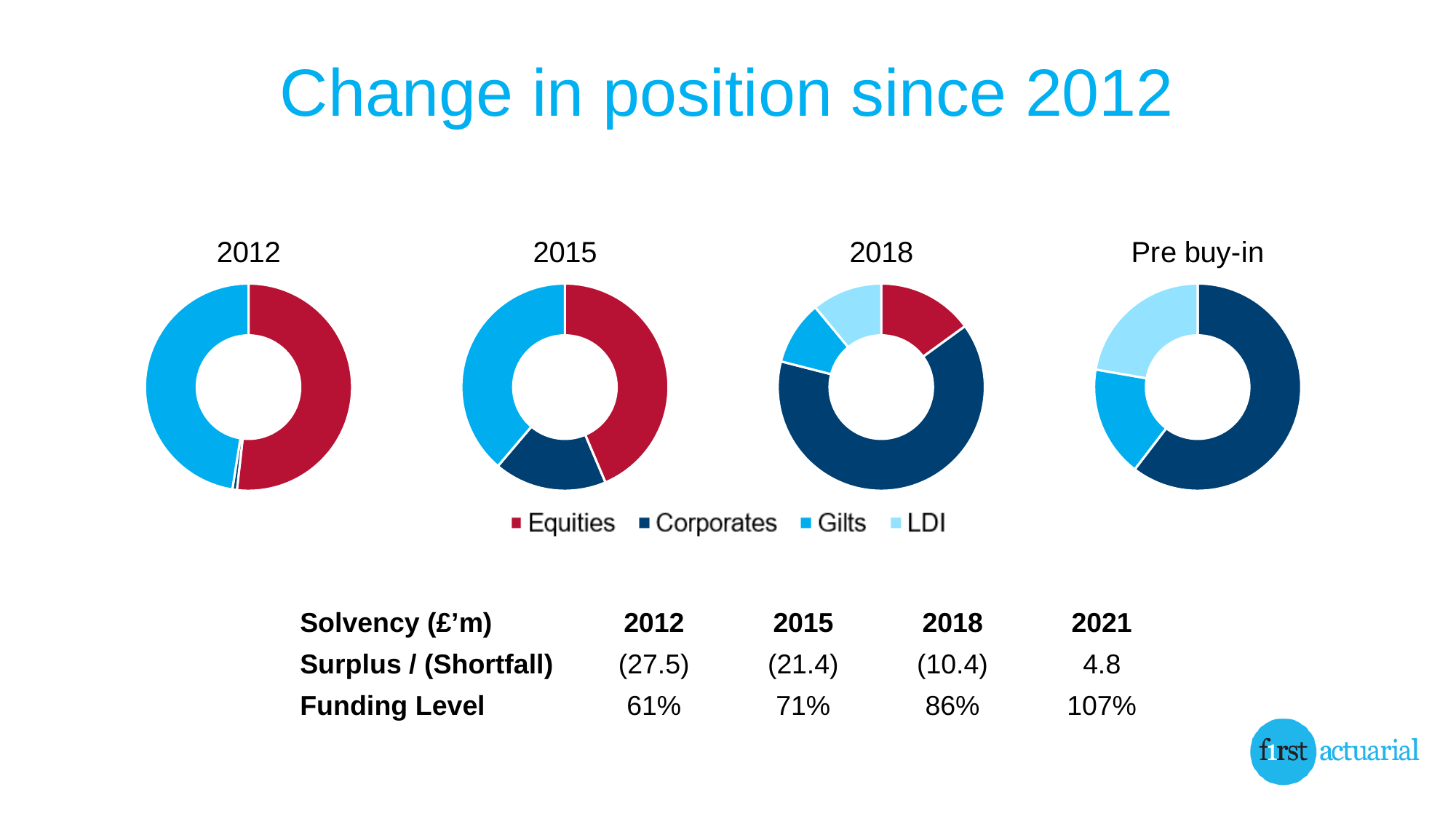
In the 2018 chart, which asset class has the largest share? Corporates How many series does the legend list for the doughnut charts? 4 In the 2012 chart, which asset class has the smallest share? Corporates What kind of chart is used for the 2012 chart? Doughnut chart In the Pre buy-in chart, which is larger, the LDI share or the Corporates share? Corporates What colour represents Equities in the legend? Red In the Pre buy-in chart, which asset class has the largest share? Corporates How many doughnut charts are shown on the slide? 4 In the 2015 chart, which asset class has the smallest share? Corporates Which asset class from the legend does not appear in the Pre buy-in chart? Equities In the 2015 chart, which is larger, the Corporates share or the Gilts share? Gilts In the 2018 chart, which is larger, the Equities share or the Corporates share? Corporates